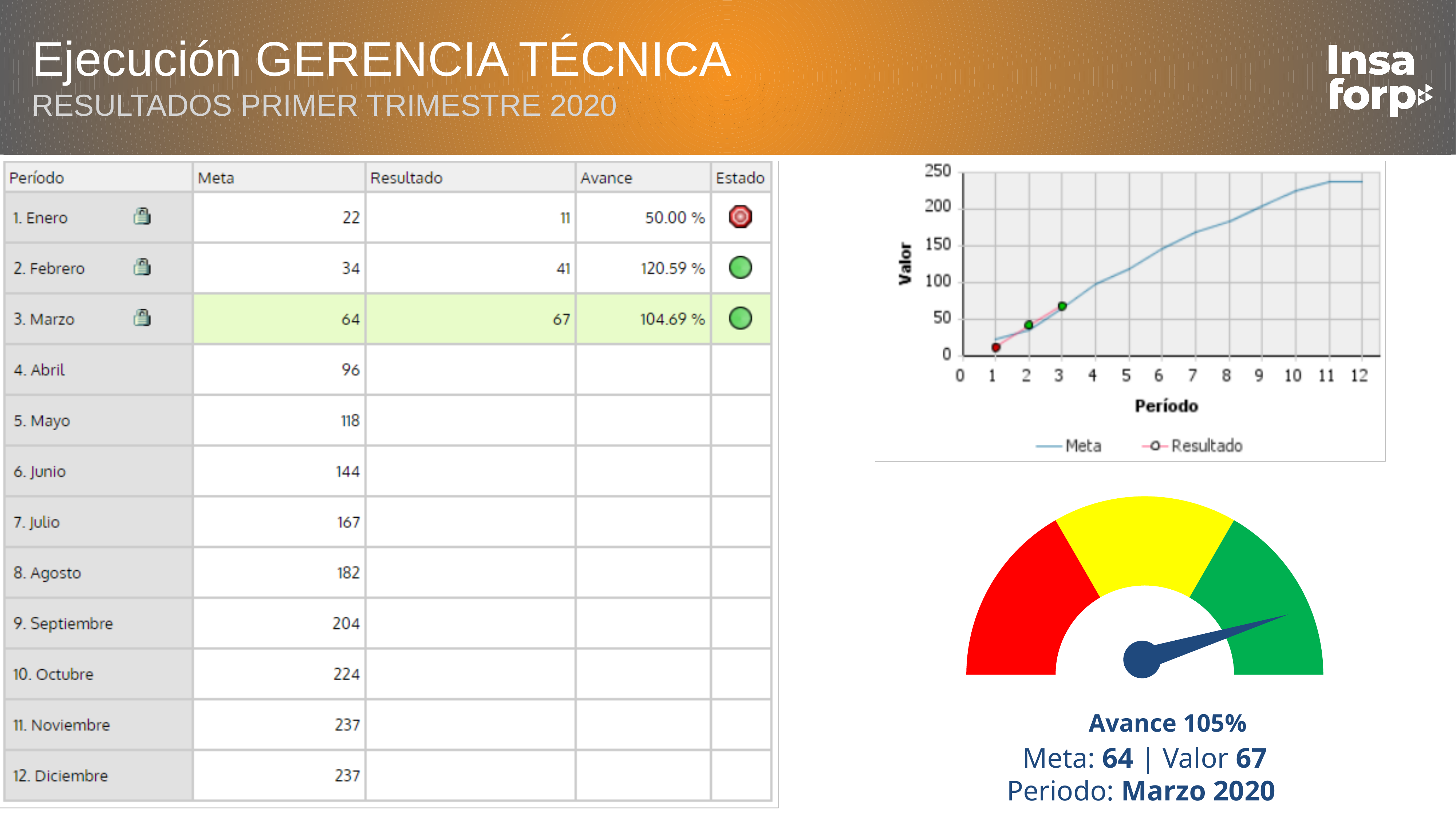
How many series does the legend of the line chart list? 2 What Avance percentage is shown below the gauge chart? 105% In the line chart, is the Meta value at period 7 greater or less than 150? greater What kind of chart is the lower chart on the right side of the slide? gauge chart What are the two series named in the legend of the line chart? Meta and Resultado In the line chart, how many data points does the Resultado series have? 3 What kind of chart is the upper chart on the right side of the slide? line chart In the line chart, is the Resultado value at period 1 greater or less than 50? less In the line chart, is the Resultado value at period 3 greater or less than 50? greater In the line chart, does the Meta series rise or fall as the period increases from 1 to 12? rise What is the label of the y axis of the line chart? Valor